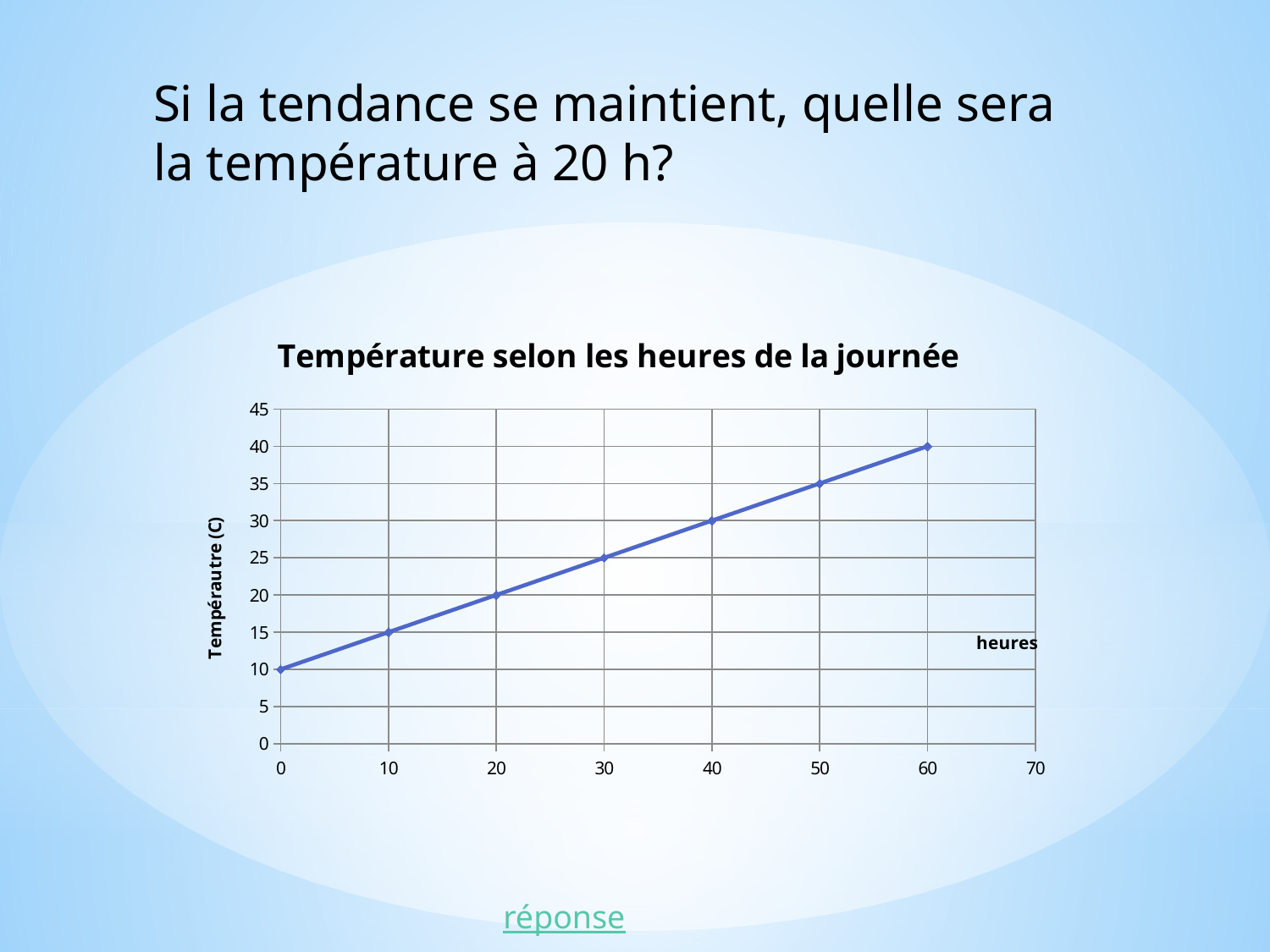
What is the temperature value at 0 hours? 10 What type of chart is shown on the slide? line chart What is the temperature value at 60 hours? 40 Do the temperature values rise or fall as the hours increase? rise How many data points are plotted on the line? 7 What is the label on the x axis of the chart? heures What is the difference between the temperature at 60 hours and at 0 hours? 30 What is the title of the chart? Température selon les heures de la journée What is the temperature value at 30 hours? 25 Which is larger, the temperature at 20 hours or at 50 hours? 50 hours At which x value is the temperature highest? 60 At which x value is the temperature lowest? 0